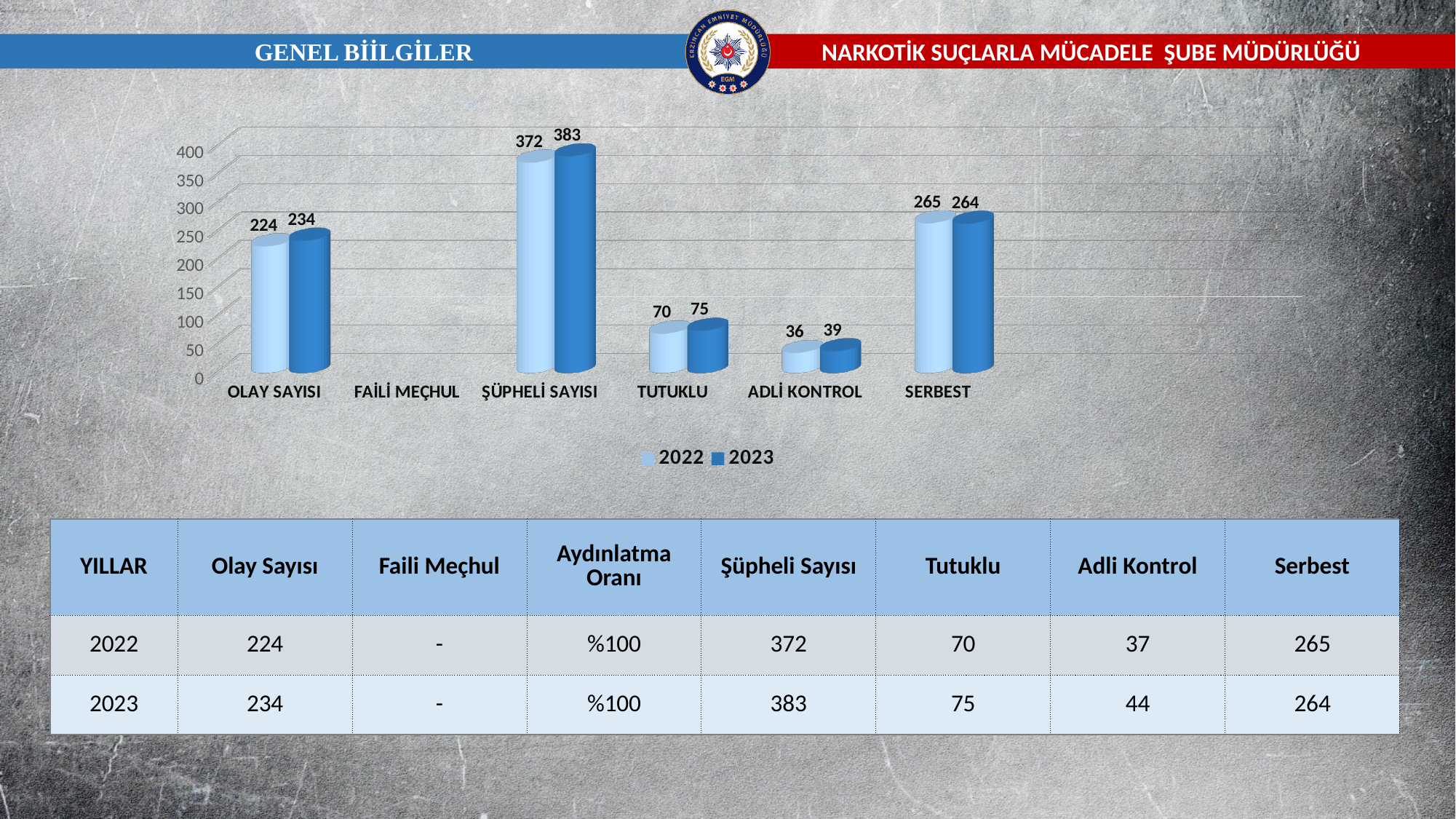
Among the categories with bars, which has the lowest 2022 value in the chart? ADLİ KONTROL What is the difference between the 2023 and 2022 values for OLAY SAYISI in the chart? 10 How many series does the chart legend list? 2 What is the difference between the 2023 and 2022 values for ŞÜPHELİ SAYISI in the chart? 11 What is the 2023 value for ŞÜPHELİ SAYISI in the chart? 383 What kind of chart is shown on the slide? bar chart What is the 2022 value for OLAY SAYISI in the chart? 224 In the chart, is the 2022 value for TUTUKLU greater or less than 100? less How many categories are shown on the x axis of the chart? 6 What is the 2022 value for SERBEST in the chart? 265 Which category has the highest 2023 value in the chart? ŞÜPHELİ SAYISI What is the 2023 value for TUTUKLU in the chart? 75